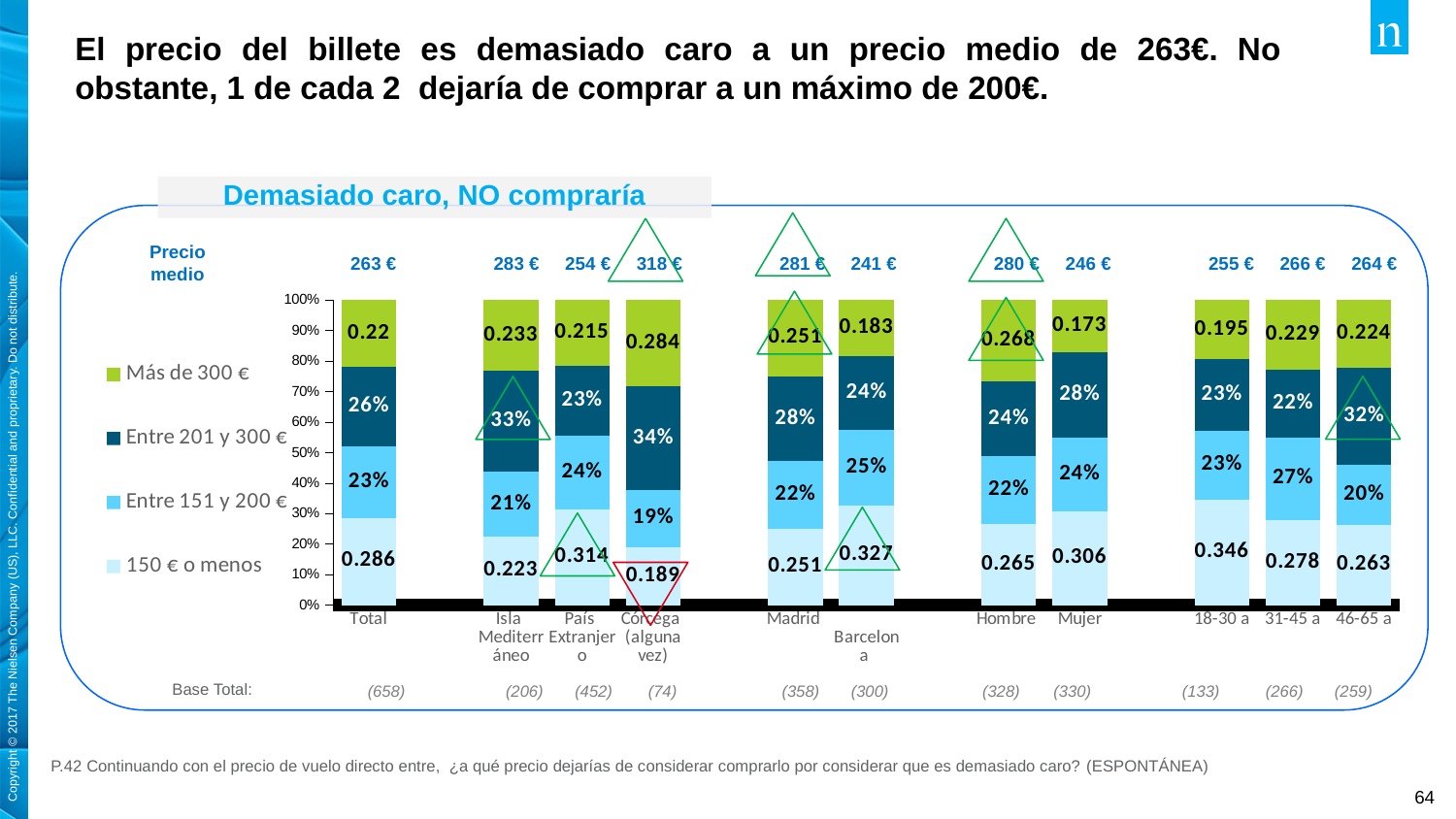
What is the 'Precio medio' shown above the Córcega (alguna vez) bar? 318 € Which is larger for 'Entre 151 y 200 €': Madrid or Barcelona? Barcelona What is the value of 'Entre 201 y 300 €' for Isla Mediterráneo? 33% How many categories are plotted along the x axis? 11 Which category has the highest value for '150 € o menos'? 18-30 a How many series does the legend list? 4 What kind of chart is shown on the slide? stacked bar chart What is the value of 'Entre 151 y 200 €' for 31-45 a? 27% What is the value of '150 € o menos' for 18-30 a? 0.346 What is the Base Total shown for the Total bar? (658) What is the difference between Mujer and Hombre for 'Entre 201 y 300 €'? 4 percentage points What is the value of 'Más de 300 €' for Total? 0.22